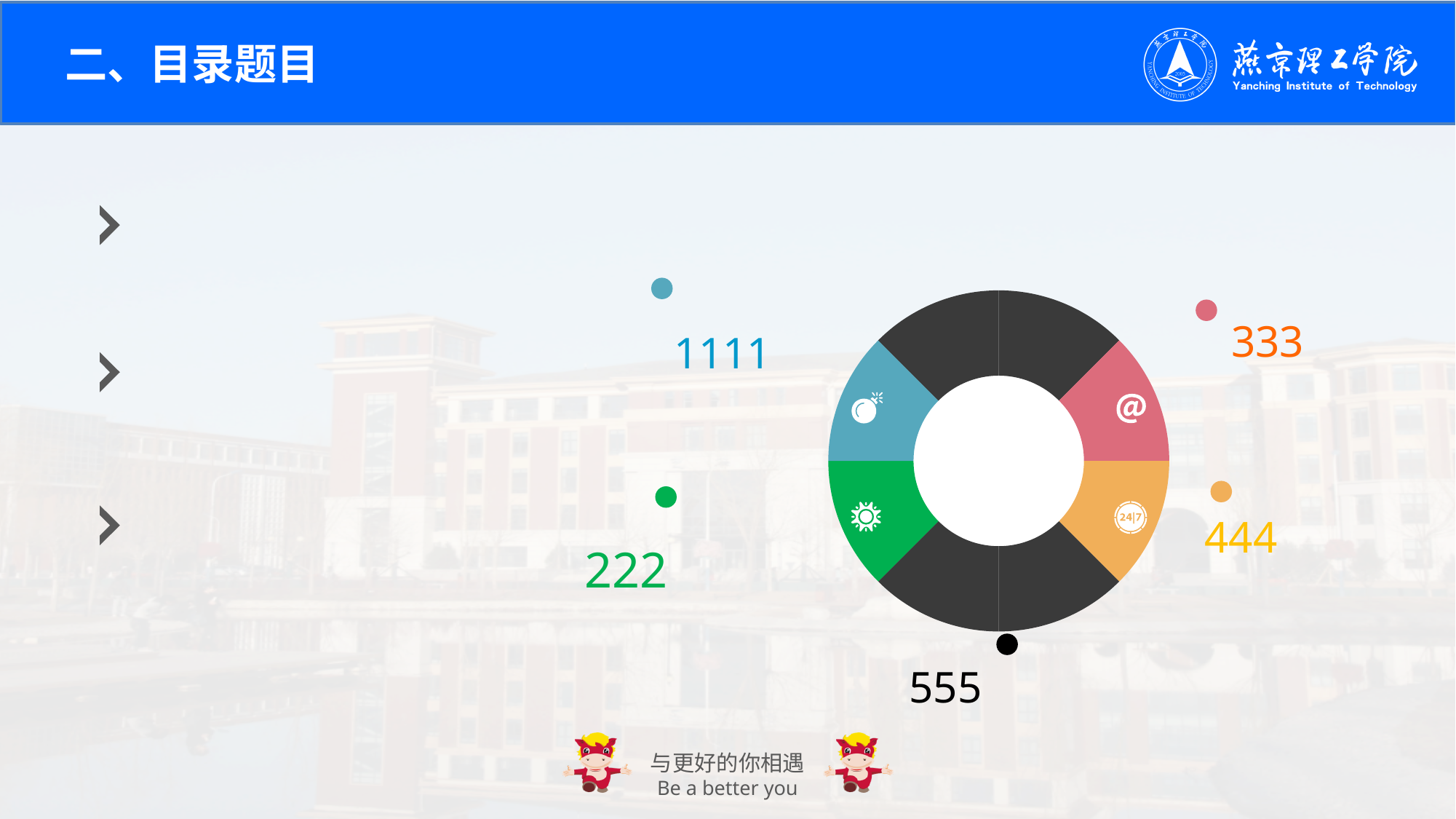
What value label is shown next to the red dot on the chart? 333 What value label is shown below the chart next to the black dot? 555 What value label is shown next to the blue dot on the chart? 1111 What colour is the segment of the donut associated with the label 222? green How many value labels are placed around the donut chart? 5 What value label is shown next to the green dot on the chart? 222 What kind of chart is shown on the slide? donut chart What value label is shown next to the orange dot on the chart? 444 Which label is positioned at the bottom of the donut chart? 555